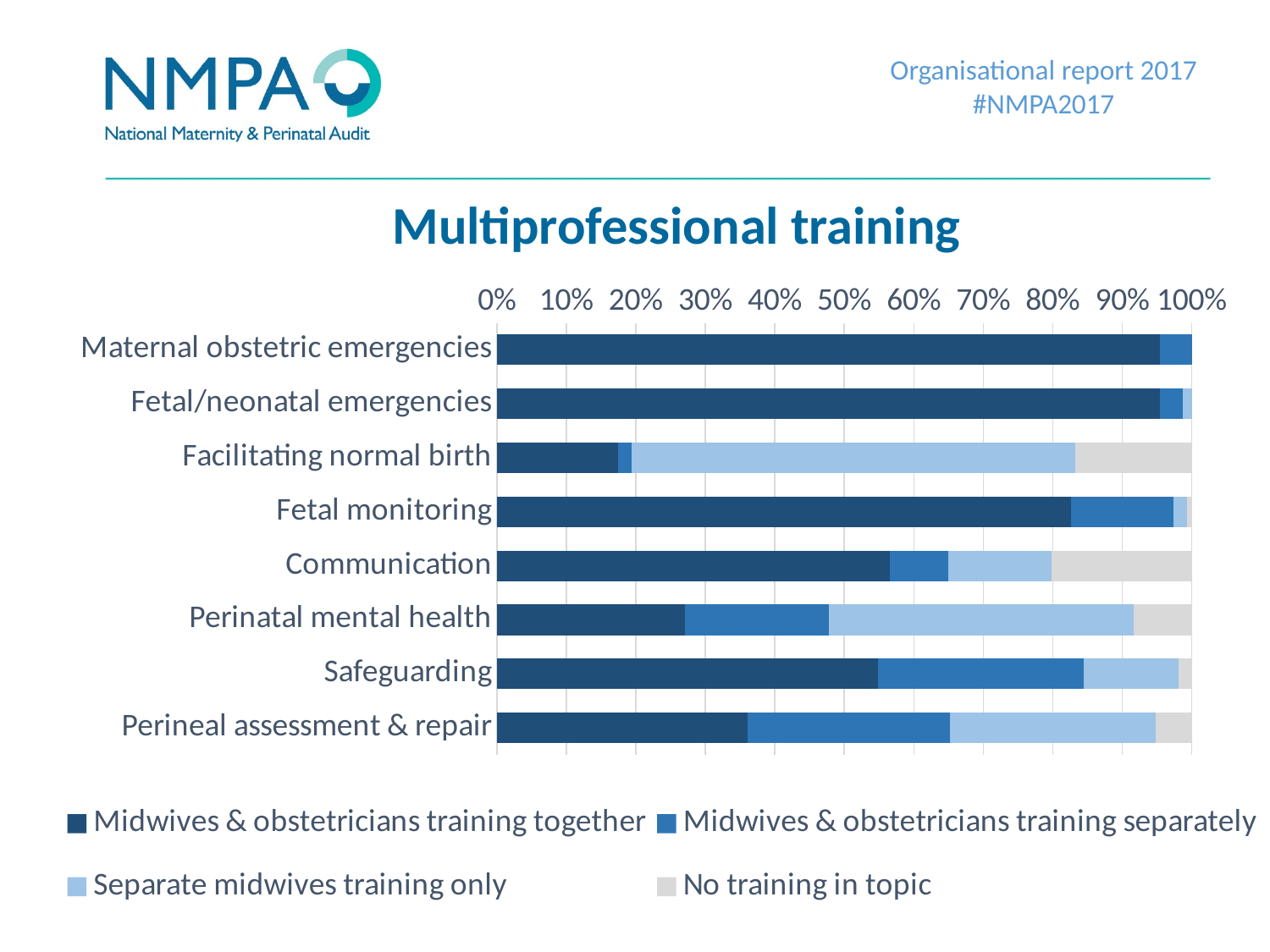
How many series does the legend list? 4 Is the 'Midwives & obstetricians training together' value for Facilitating normal birth greater or less than 20%? less Is the 'Midwives & obstetricians training together' value for Perinatal mental health greater or less than 30%? less How many categories (training topics) are plotted on the chart? 8 Is the 'Midwives & obstetricians training together' value for Communication greater or less than 50%? greater Which legend entry is shown in the lightest grey colour? No training in topic Which training topic has the smallest share of 'Midwives & obstetricians training together'? Facilitating normal birth What is the title of the chart? Multiprofessional training What type of chart is shown on the slide? Stacked bar chart Which has a larger 'Midwives & obstetricians training together' share: Facilitating normal birth or Perinatal mental health? Perinatal mental health Which has a larger 'Midwives & obstetricians training together' share: Communication or Perineal assessment & repair? Communication